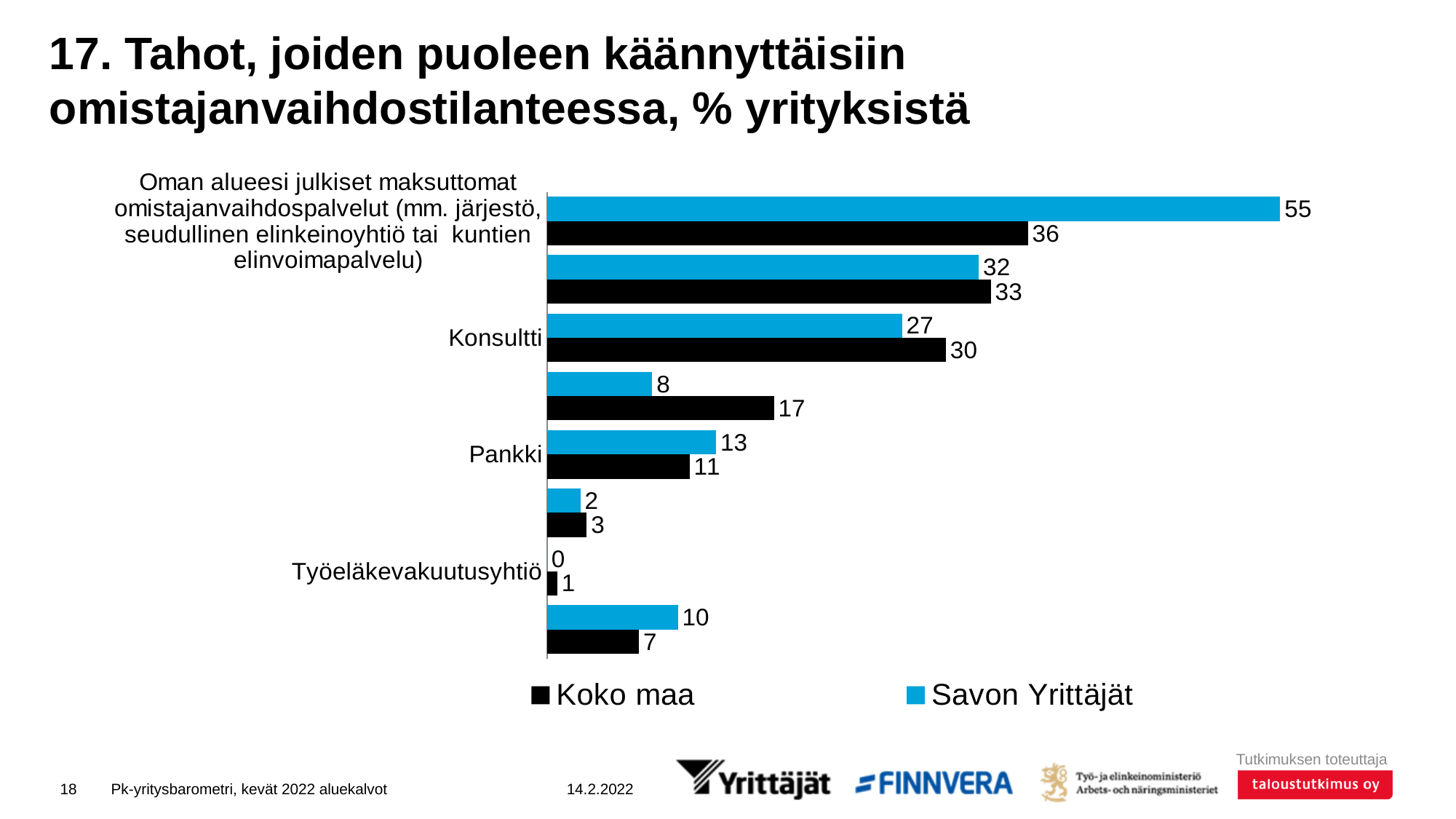
How many series does the legend list? 2 Which category has the highest value for Savon Yrittäjät? Oman alueesi julkiset maksuttomat omistajanvaihdospalvelut What kind of chart is shown on the slide? bar chart What is the Koko maa value for Konsultti? 30 What is the value for Koko maa for 'Oman alueesi julkiset maksuttomat omistajanvaihdospalvelut'? 36 For Konsultti, which series has the larger value, Koko maa or Savon Yrittäjät? Koko maa What is the Savon Yrittäjät value for Pankki? 13 What is the difference between the Savon Yrittäjät and Koko maa values for 'Oman alueesi julkiset maksuttomat omistajanvaihdospalvelut'? 19 What is the value for Savon Yrittäjät for 'Oman alueesi julkiset maksuttomat omistajanvaihdospalvelut'? 55 What is the Koko maa value for Työeläkevakuutusyhtiö? 1 How many categories (pairs of bars) are plotted in the chart? 8 Which category has the lowest value for Savon Yrittäjät? Työeläkevakuutusyhtiö